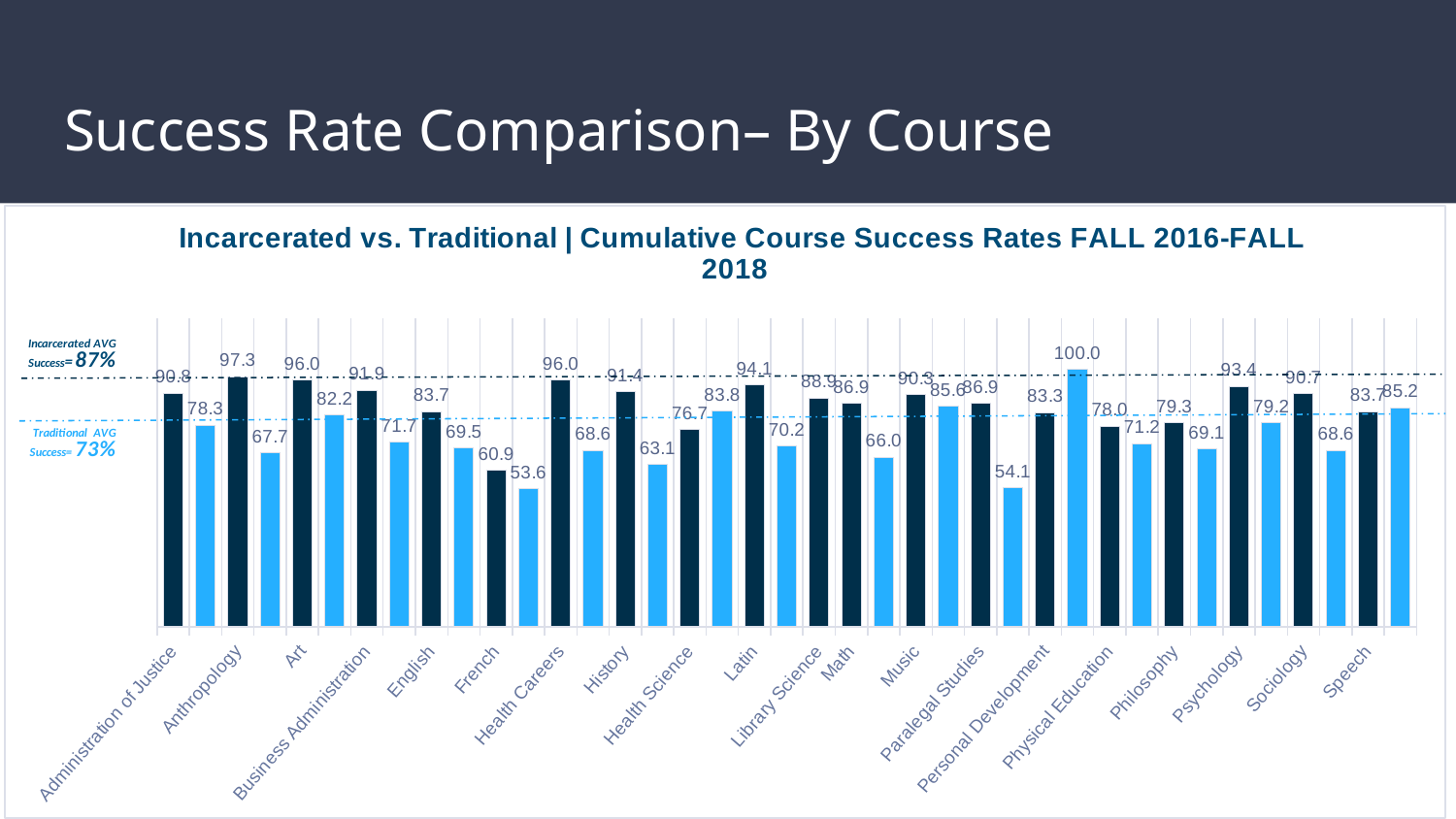
What is the incarcerated (dark bar) success rate for Health Careers? 96.0 What is the difference between the incarcerated and traditional success rates for Administration of Justice? 12.5 What is the incarcerated (dark bar) success rate for Psychology? 93.4 What kind of chart is shown on the slide? Bar chart What is the Incarcerated AVG Success rate noted on the chart? 87% How many courses are shown on the x axis of the chart? 20 What is the difference between the incarcerated and traditional success rates for Anthropology? 29.6 What is the incarcerated (dark bar) success rate for Anthropology? 97.3 For Art, which is larger: the incarcerated success rate or the traditional success rate? Incarcerated Which course has the highest incarcerated (dark bar) success rate? Anthropology What is the traditional (light blue bar) success rate for French? 53.6 Which course has the lowest incarcerated (dark bar) success rate? French